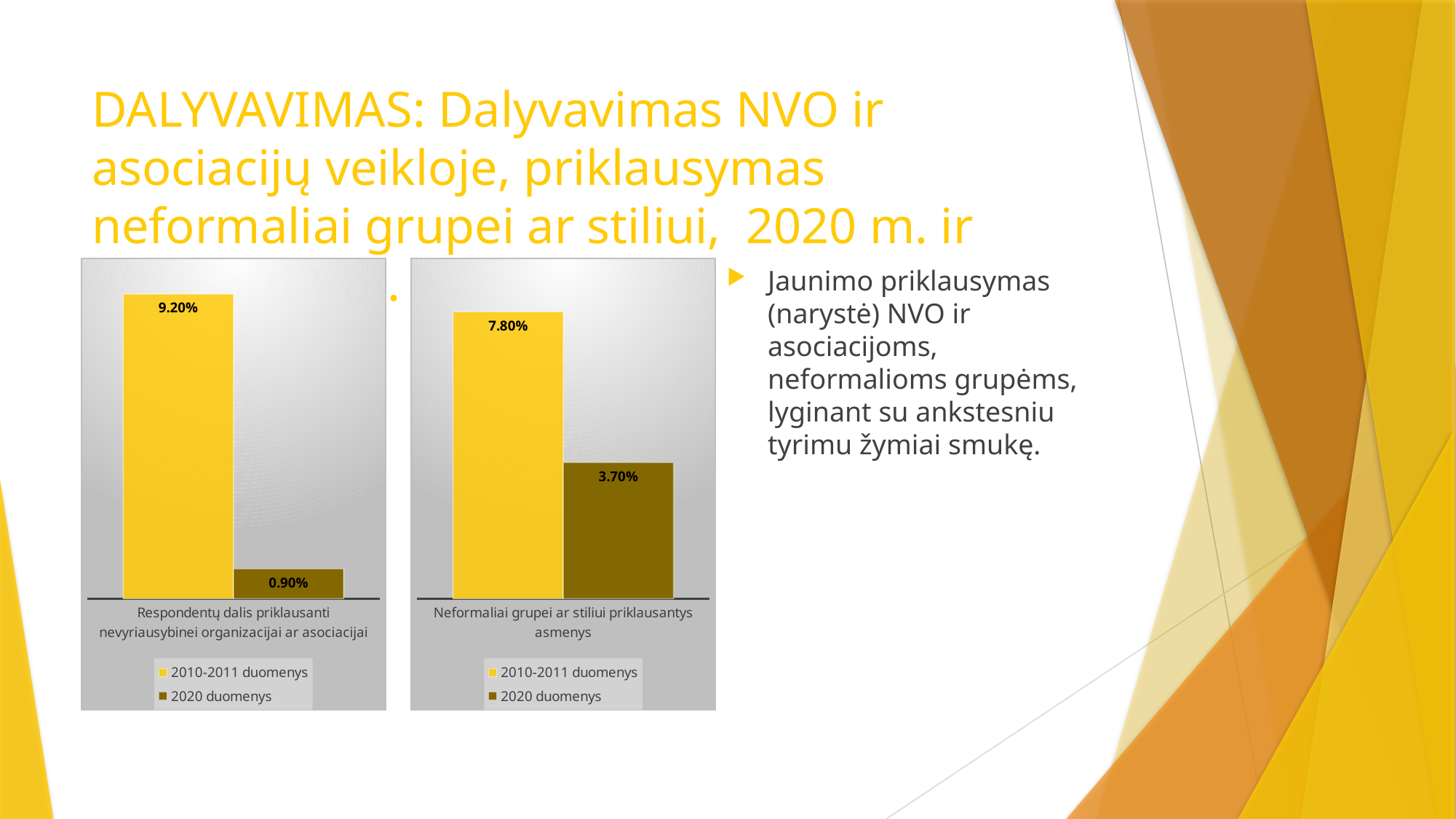
In the right chart (Neformaliai grupei ar stiliui priklausantys asmenys), what is the value for 2020 duomenys? 3.70% In the right chart (Neformaliai grupei ar stiliui priklausantys asmenys), what is the value for 2010-2011 duomenys? 7.80% What kind of chart is the right chart (Neformaliai grupei ar stiliui priklausantys asmenys)? Bar chart How many series does the legend of the left chart list? 2 In the right chart, which series has the lower value? 2020 duomenys In the left chart, which series has the higher value, 2010-2011 duomenys or 2020 duomenys? 2010-2011 duomenys Which of the two charts shows the larger 2020 duomenys value? The right chart (Neformaliai grupei ar stiliui priklausantys asmenys) In the left chart (Respondentų dalis priklausanti nevyriausybinei organizacijai ar asociacijai), what is the value for 2010-2011 duomenys? 9.20% In the right chart, what is the difference between the 2010-2011 duomenys value and the 2020 duomenys value? 4.10% In the left chart, what is the difference between the 2010-2011 duomenys value and the 2020 duomenys value? 8.30% In the left chart (Respondentų dalis priklausanti nevyriausybinei organizacijai ar asociacijai), what is the value for 2020 duomenys? 0.90% Which series is shown in dark brown in the right chart's legend? 2020 duomenys